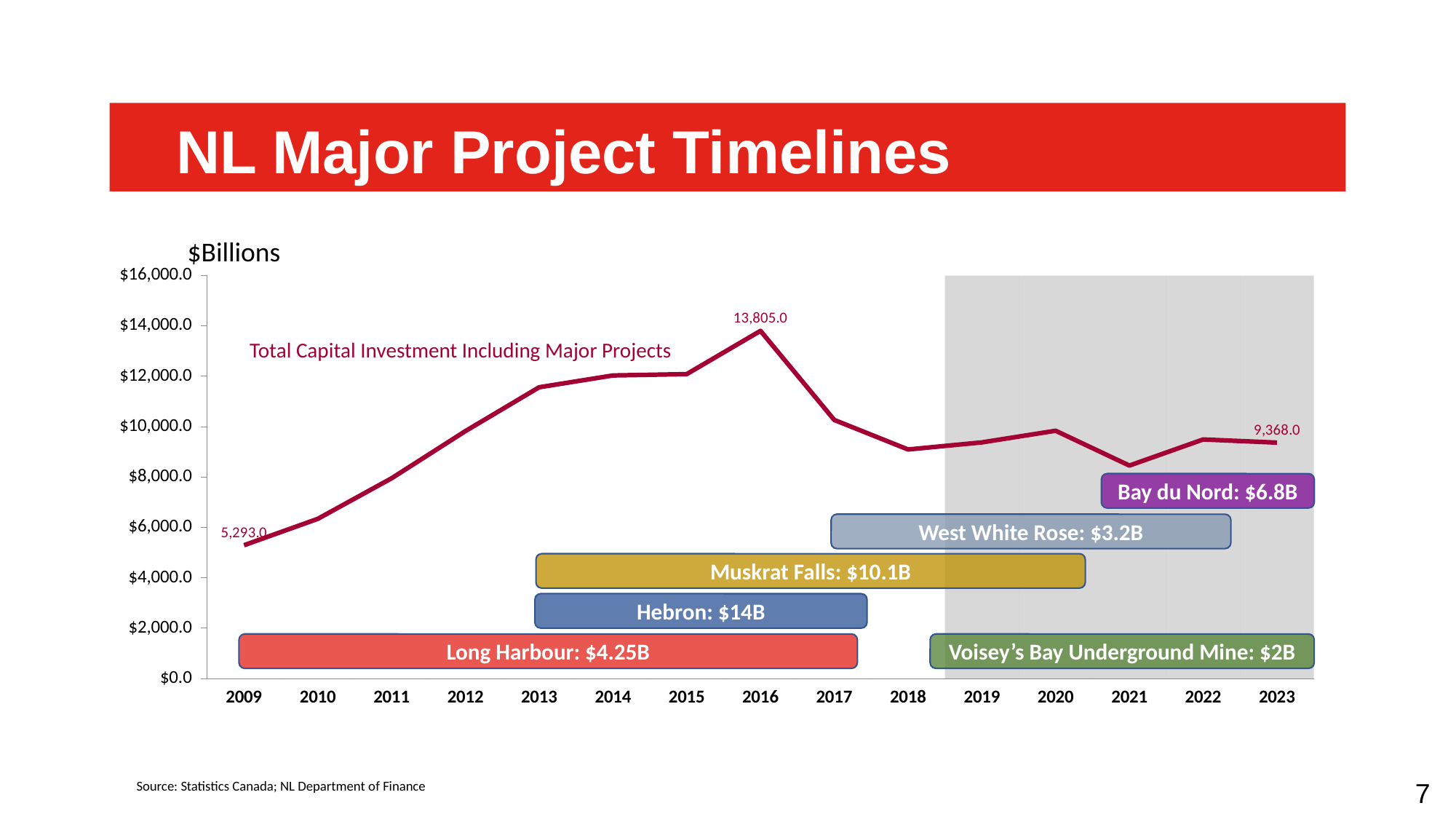
In which year is Total Capital Investment Including Major Projects highest? 2016 In which year is Total Capital Investment Including Major Projects lowest? 2009 How many years are shown on the x axis of the chart? 15 What is the value of Total Capital Investment Including Major Projects in 2016? 13,805.0 Does Total Capital Investment Including Major Projects rise or fall from 2009 to 2016? rises What is the value of Total Capital Investment Including Major Projects in 2023? 9,368.0 What is the value of Total Capital Investment Including Major Projects in 2009? 5,293.0 What kind of chart is used to show Total Capital Investment Including Major Projects? line chart Is the Total Capital Investment value for 2021 greater or less than $10,000.0? less Is the Total Capital Investment value for 2015 greater or less than $10,000.0? greater Which year has the larger Total Capital Investment value, 2016 or 2023? 2016 What is the difference between the 2016 and 2009 values of Total Capital Investment Including Major Projects? 8,512.0